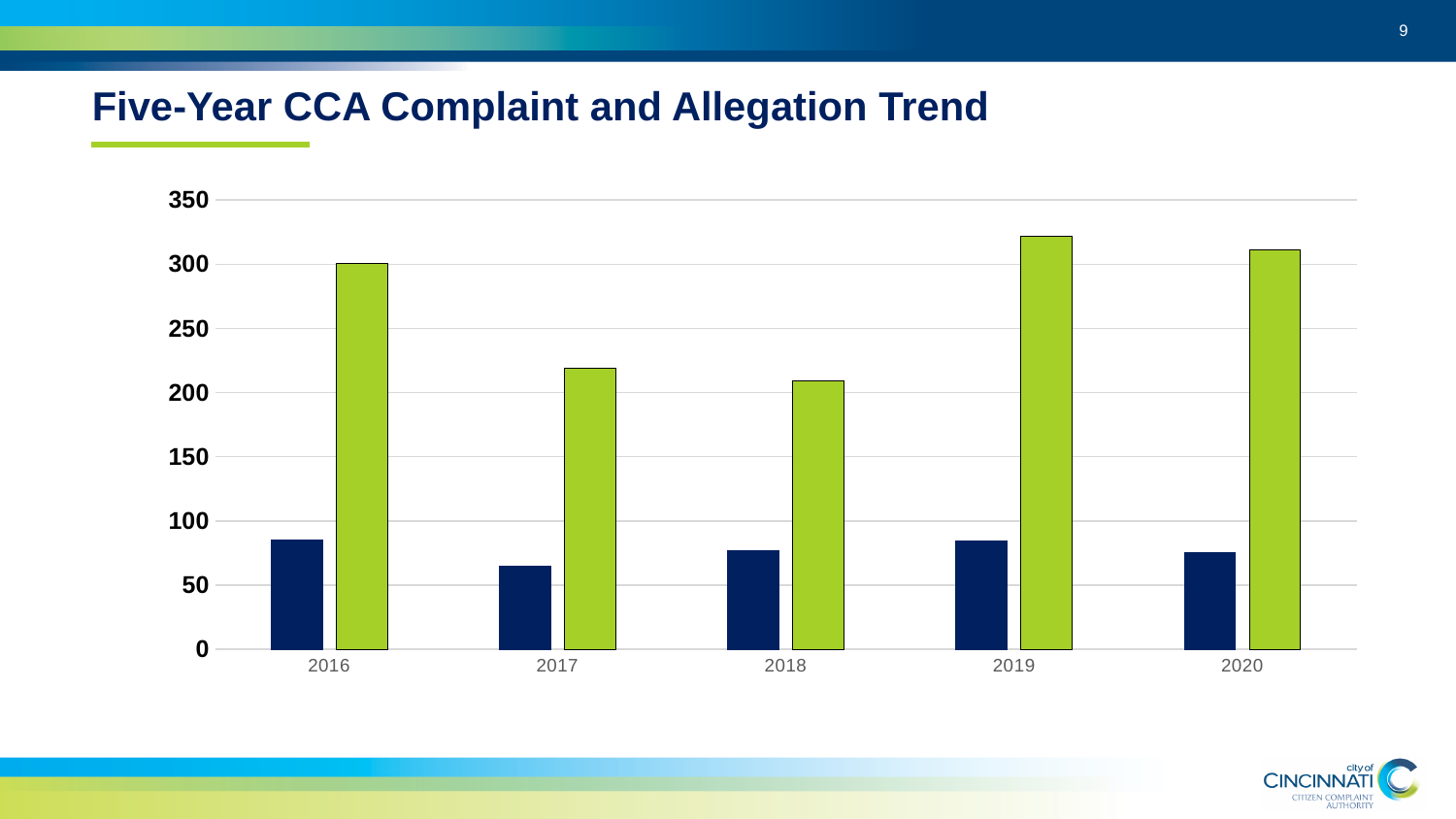
What kind of chart is shown on the slide? Bar chart Which is taller, the green bar for 2016 or the green bar for 2017? 2016 Is the green bar for 2019 greater or less than 300? greater How many bars are plotted for each year in the chart? 2 In which year is the green bar the tallest? 2019 Is the green bar for 2017 greater or less than 200? greater What is the title of the chart? Five-Year CCA Complaint and Allegation Trend In which year is the dark blue bar the shortest? 2017 Which is taller, the dark blue bar for 2018 or the dark blue bar for 2017? 2018 Is the green bar for 2018 greater or less than 250? less How many years are shown on the x axis of the chart? 5